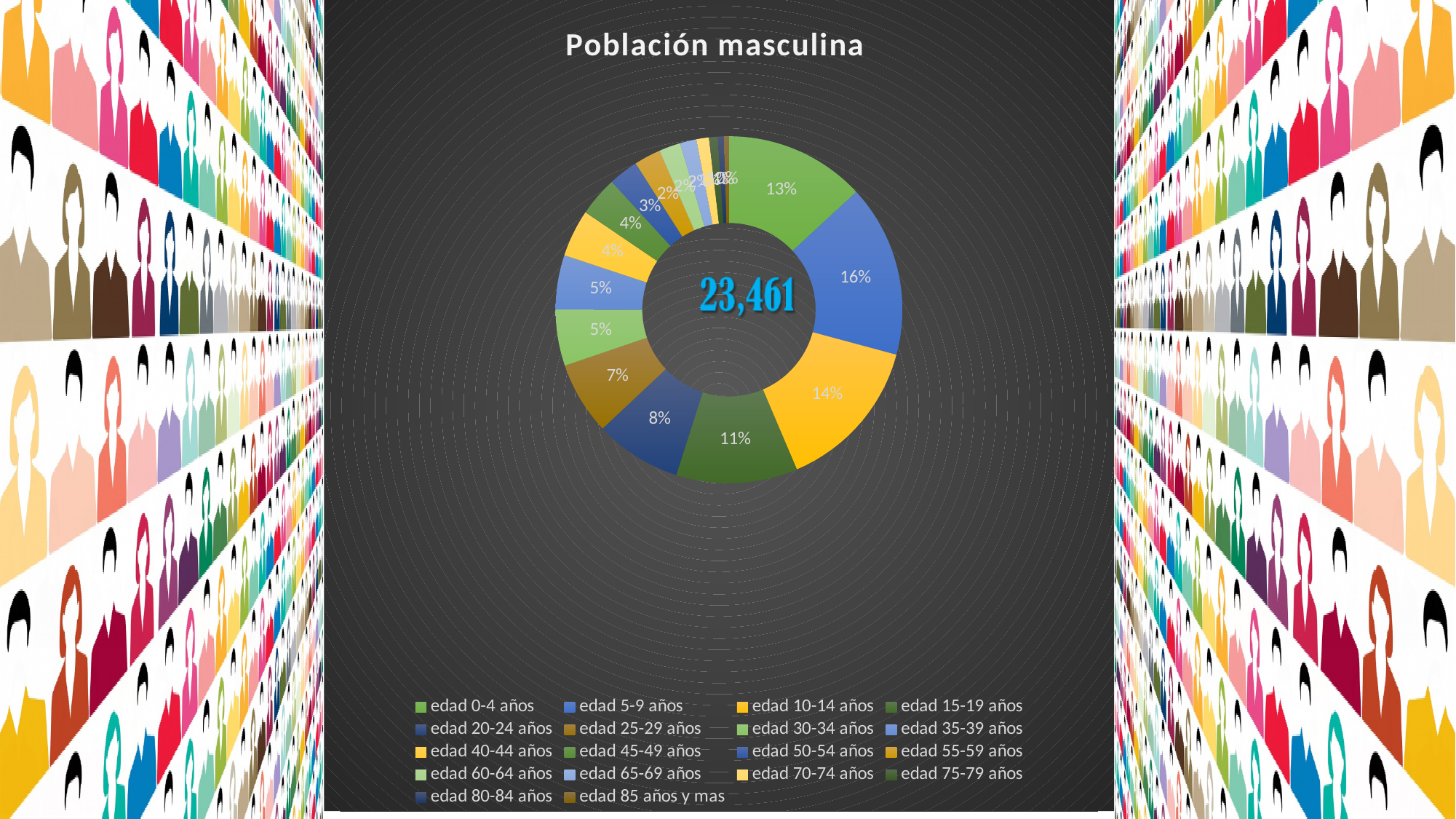
How many age groups does the legend list? 18 What kind of chart is shown on the slide? doughnut (pie) chart What is the difference in percentage points between the 'edad 5-9 años' share and the 'edad 25-29 años' share? 9 What share of the male population is in the 'edad 0-4 años' group? 13% What number is displayed in the centre of the doughnut chart? 23,461 What is the title of the chart? Población masculina What share of the male population is in the 'edad 20-24 años' group? 8% Which is larger, the share for 'edad 10-14 años' or for 'edad 15-19 años'? edad 10-14 años Which age group has the largest share of the male population? edad 5-9 años What share of the male population is in the 'edad 10-14 años' group? 14% What share of the male population is in the 'edad 5-9 años' group? 16% What share of the male population is in the 'edad 15-19 años' group? 11%